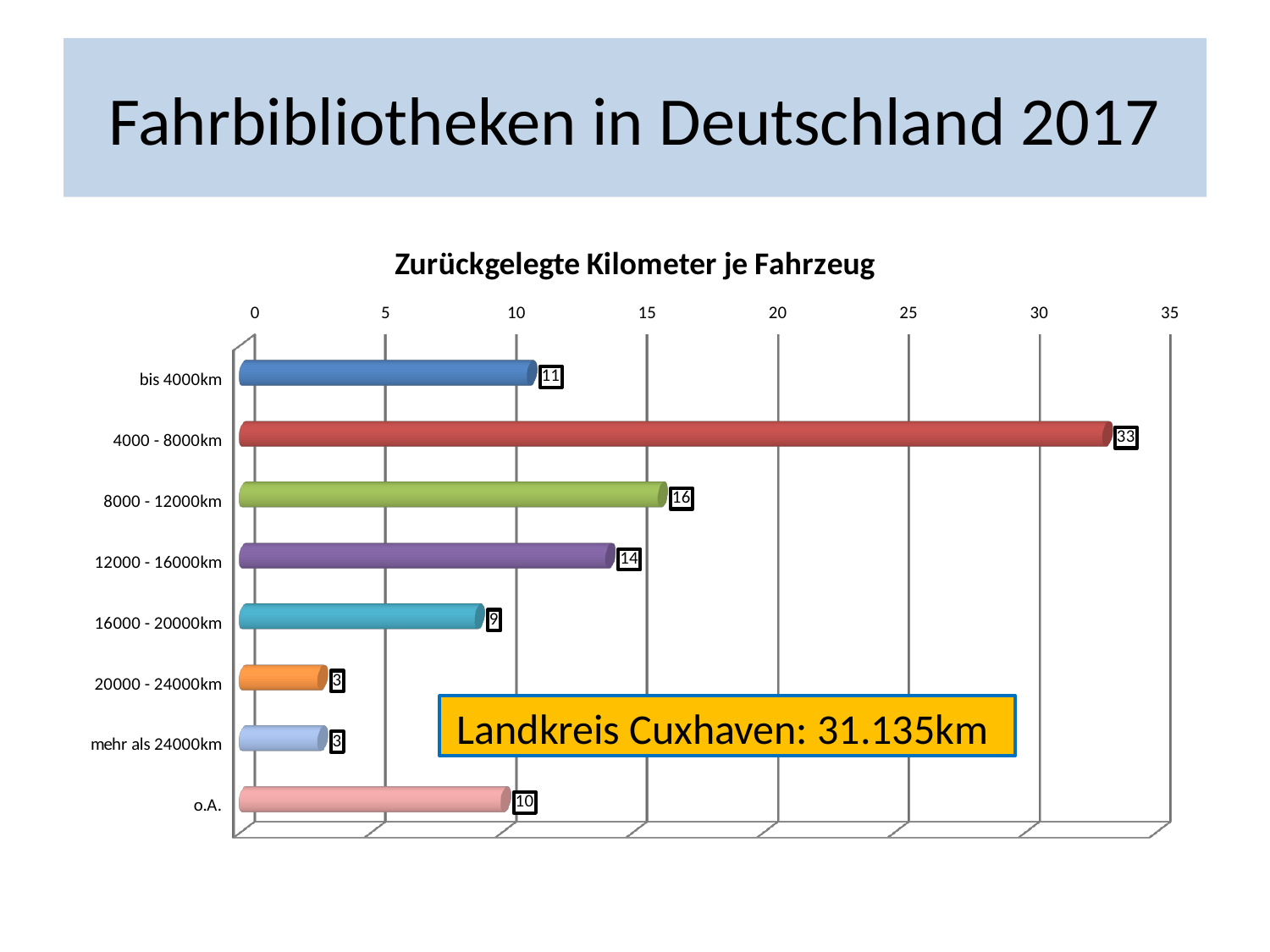
How many categories are shown in the chart? 8 What is the value for the category "bis 4000km"? 11 What kind of chart is shown on the slide? bar chart Which is larger, the value for "8000 - 12000km" or the value for "o.A."? 8000 - 12000km What is the difference between the values for "8000 - 12000km" and "12000 - 16000km"? 2 What is the value for the category "4000 - 8000km"? 33 What is the title of the chart? Zurückgelegte Kilometer je Fahrzeug Is the value for "4000 - 8000km" greater or less than 30? greater What is the value for the category "16000 - 20000km"? 9 What is the value for the category "o.A."? 10 Which category has the highest value? 4000 - 8000km What is the difference between the values for "4000 - 8000km" and "bis 4000km"? 22